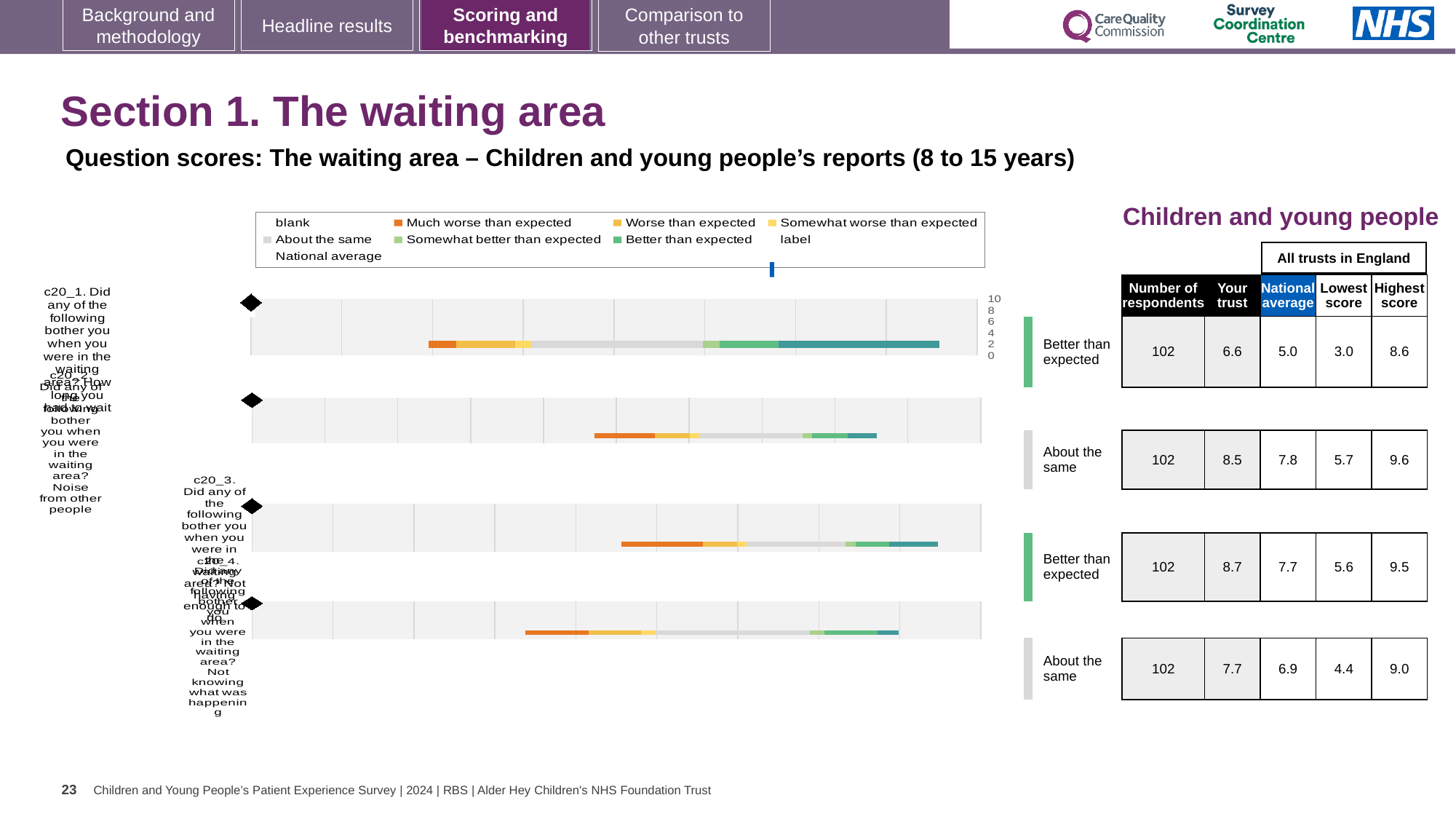
What colour does the legend use for 'Much worse than expected'? orange What is the difference between the 'Your trust' score and the national average for the second question (c20_2)? 0.7 In the table next to the charts, what is the national average for the first question (c20_1)? 5.0 In the table, what is the lowest score across all trusts in England for the fourth question (c20_4)? 4.4 In the table, what is the 'Your trust' score for the third question (c20_3)? 8.7 What kind of chart is used to show the question scores on this slide? bar chart How many separate bar charts (one per question) are shown on the slide? 4 What is the highest value shown on the numeric axis of the bar charts? 10 Which question has the highest 'Your trust' score in the table: the first, second, third or fourth? third (c20_3) How many respondents are listed for each of the four questions in the table? 102 In the table, what is the highest score across all trusts in England for the second question (c20_2)? 9.6 In the table next to the charts, what is the 'Your trust' score for the first question (c20_1)? 6.6